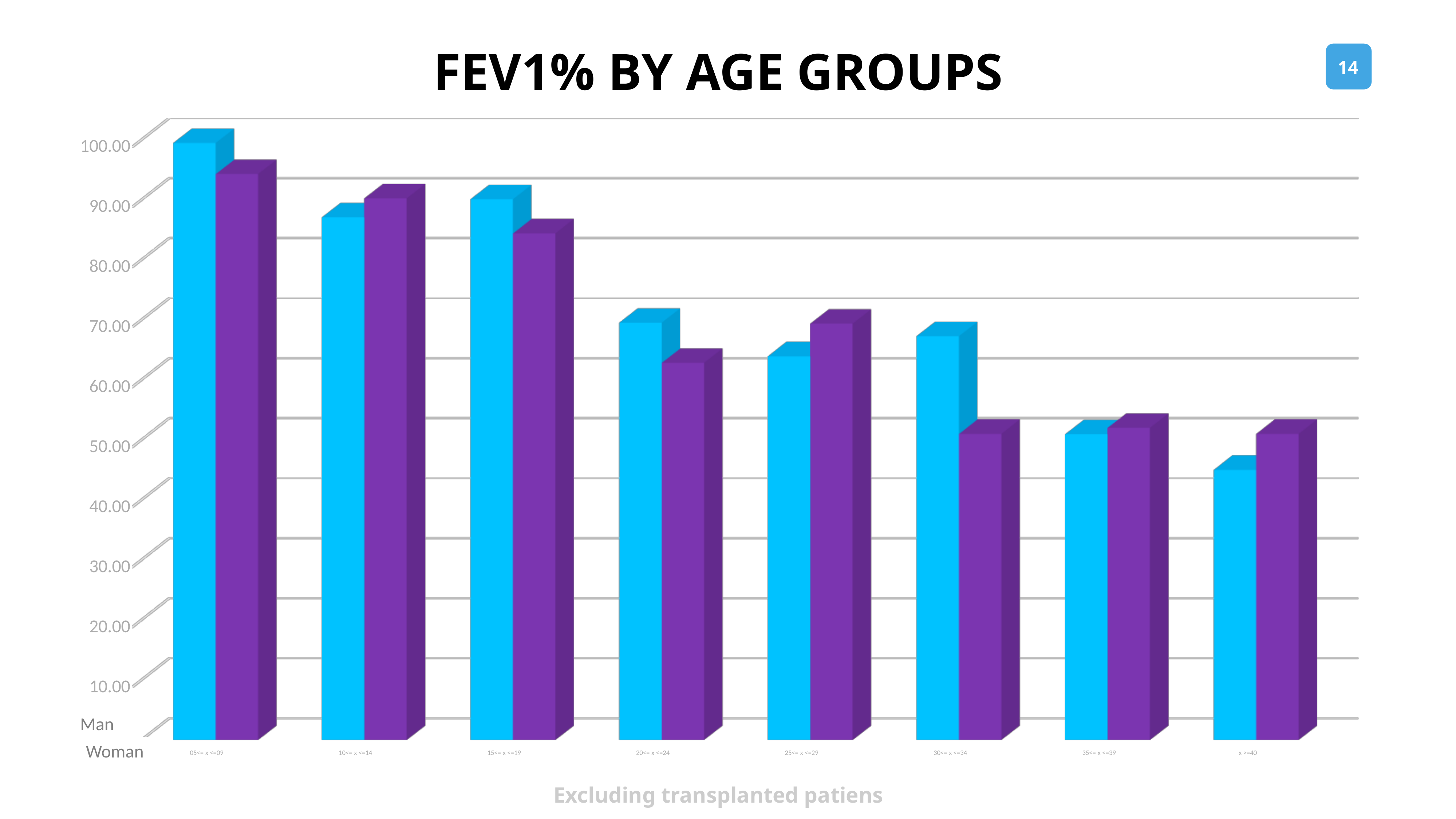
Is the value for Woman in the 30<= x <=34 age group greater or less than 60.00? less Which age group has the highest value for Man? 05<= x <=09 Do the values for Man generally rise or fall as age group increases along the x axis? Fall How many series does the chart show? 2 Which age group has the lowest value for Man? x >=40 What kind of chart is shown on the slide? Bar chart What is the title of the chart? FEV1% BY AGE GROUPS How many age-group categories are plotted on the x axis? 8 Is the value for Man in the 20<= x <=24 age group greater or less than 60.00? greater Which age group has the highest value for Woman? 05<= x <=09 In the 25<= x <=29 age group, which is larger, the value for Man or for Woman? Woman In the 05<= x <=09 age group, which is larger, the value for Man or for Woman? Man